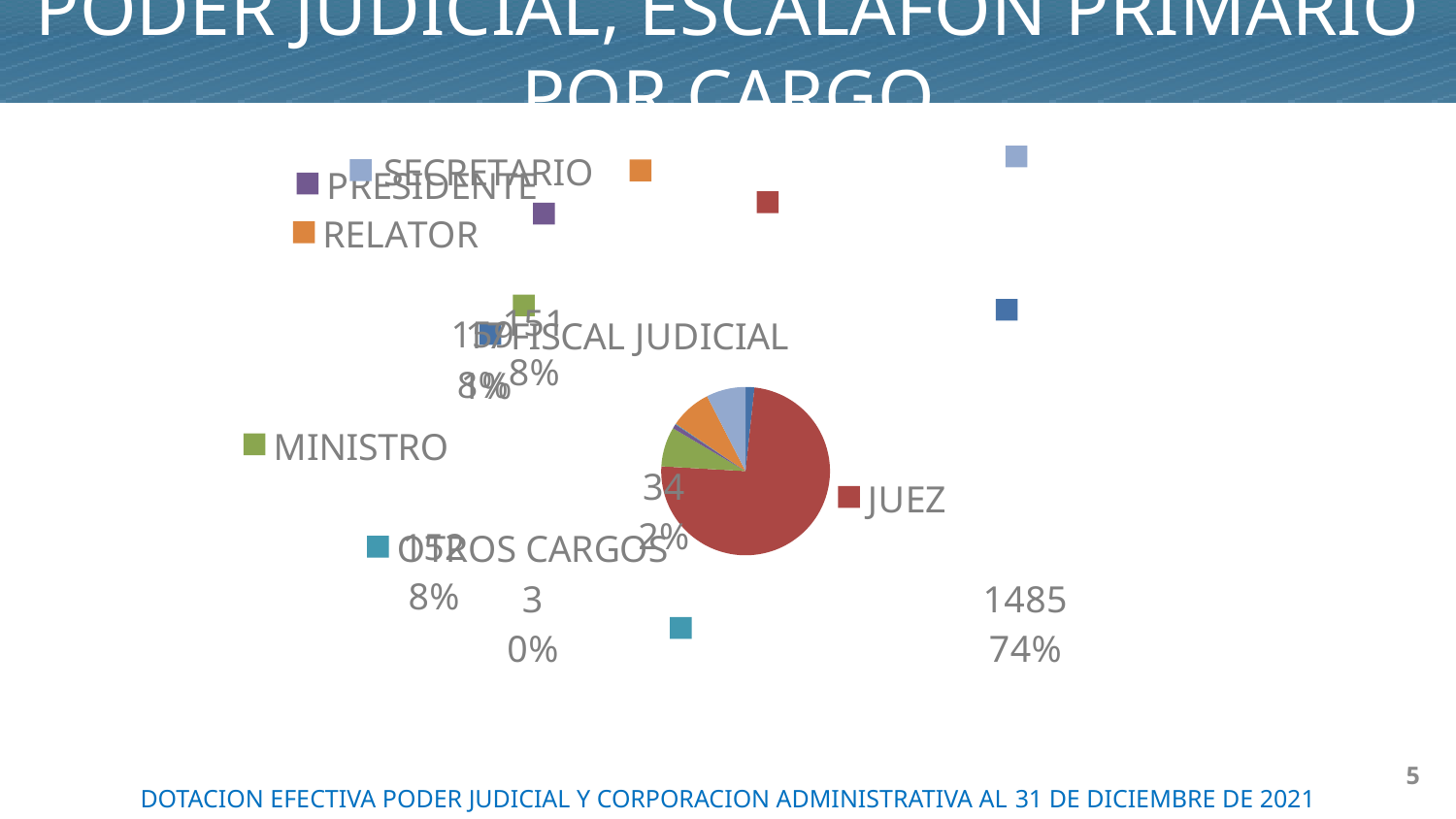
Which category has the largest slice of the pie? JUEZ What is the value shown for JUEZ? 1485 How many categories does the legend list? 7 What is the title of the chart? PODER JUDICIAL, ESCALAFON PRIMARIO POR CARGO What percentage share of the pie does JUEZ have? 74% Which is larger, the slice for JUEZ or the slice for MINISTRO? JUEZ What kind of chart is shown on the slide? pie chart What colour is the JUEZ slice in the pie chart? red